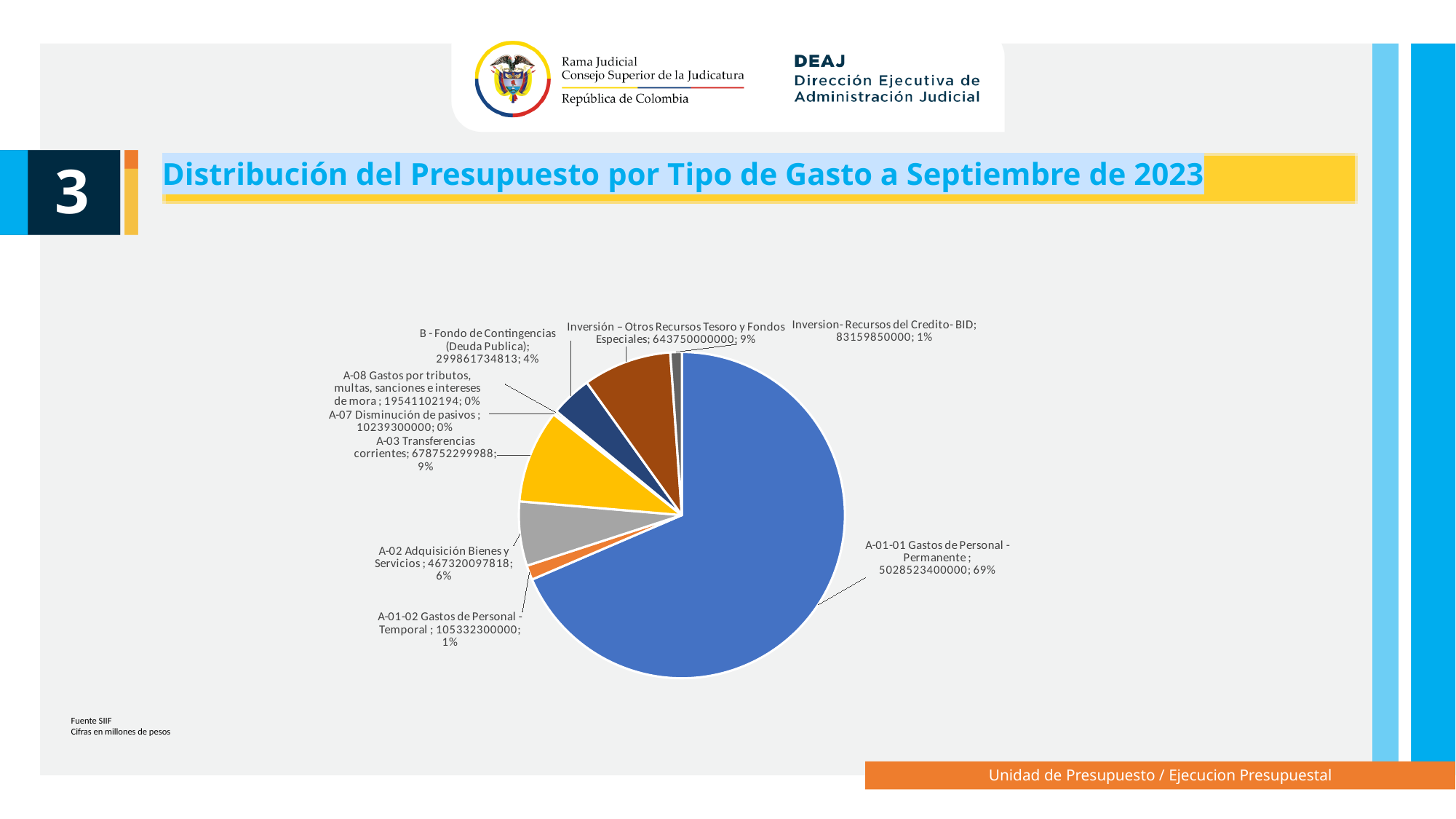
What kind of chart is shown on the slide? Pie chart What share of the pie does A-03 Transferencias corrientes represent? 9% What share of the pie does A-01-01 Gastos de Personal - Permanente represent? 69% What is the title of the chart on the slide? Distribución del Presupuesto por Tipo de Gasto a Septiembre de 2023 What is the difference between the values for A-03 Transferencias corrientes and Inversión – Otros Recursos Tesoro y Fondos Especiales? 35002299988 What is the value shown for A-01-01 Gastos de Personal - Permanente? 5028523400000 Which category has the smallest value in the pie chart? A-07 Disminución de pasivos How many slices does the pie chart have? 9 Which is larger: A-03 Transferencias corrientes or Inversión – Otros Recursos Tesoro y Fondos Especiales? A-03 Transferencias corrientes What is the value shown for B - Fondo de Contingencias (Deuda Publica)? 299861734813 What is the value shown for A-02 Adquisición Bienes y Servicios? 467320097818 Which category has the largest slice of the pie? A-01-01 Gastos de Personal - Permanente